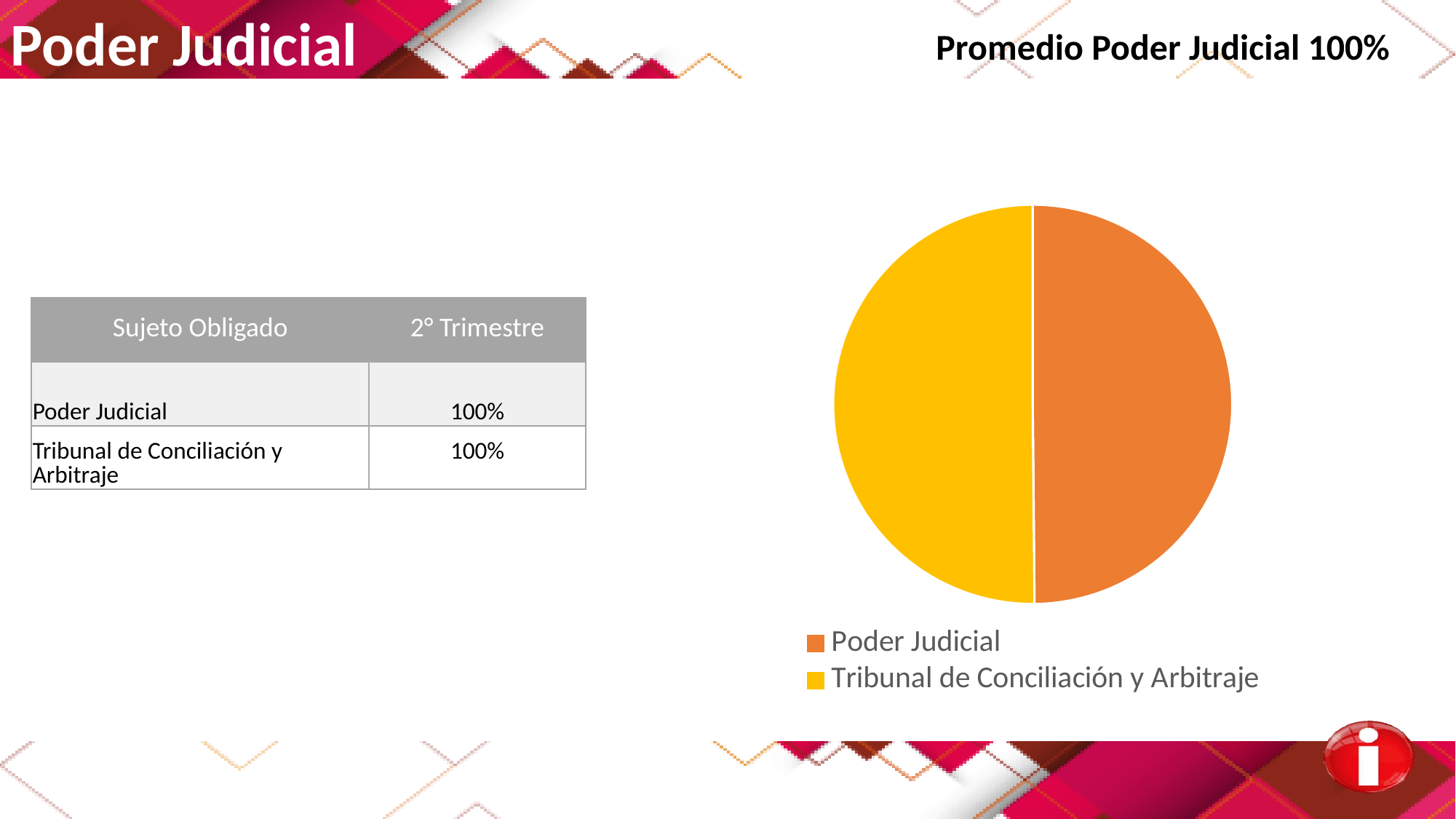
How many slices does the pie chart have? 2 Which colour represents Tribunal de Conciliación y Arbitraje in the pie chart? yellow What is the difference between the 2° Trimestre values for Poder Judicial and Tribunal de Conciliación y Arbitraje shown in the table? 0% What kind of chart is shown on the slide? pie chart According to the table next to the pie chart, what is the 2° Trimestre value for Poder Judicial? 100% Which colour represents Poder Judicial in the pie chart? orange According to the table next to the pie chart, what is the 2° Trimestre value for Tribunal de Conciliación y Arbitraje? 100% How many entries does the pie chart's legend list? 2